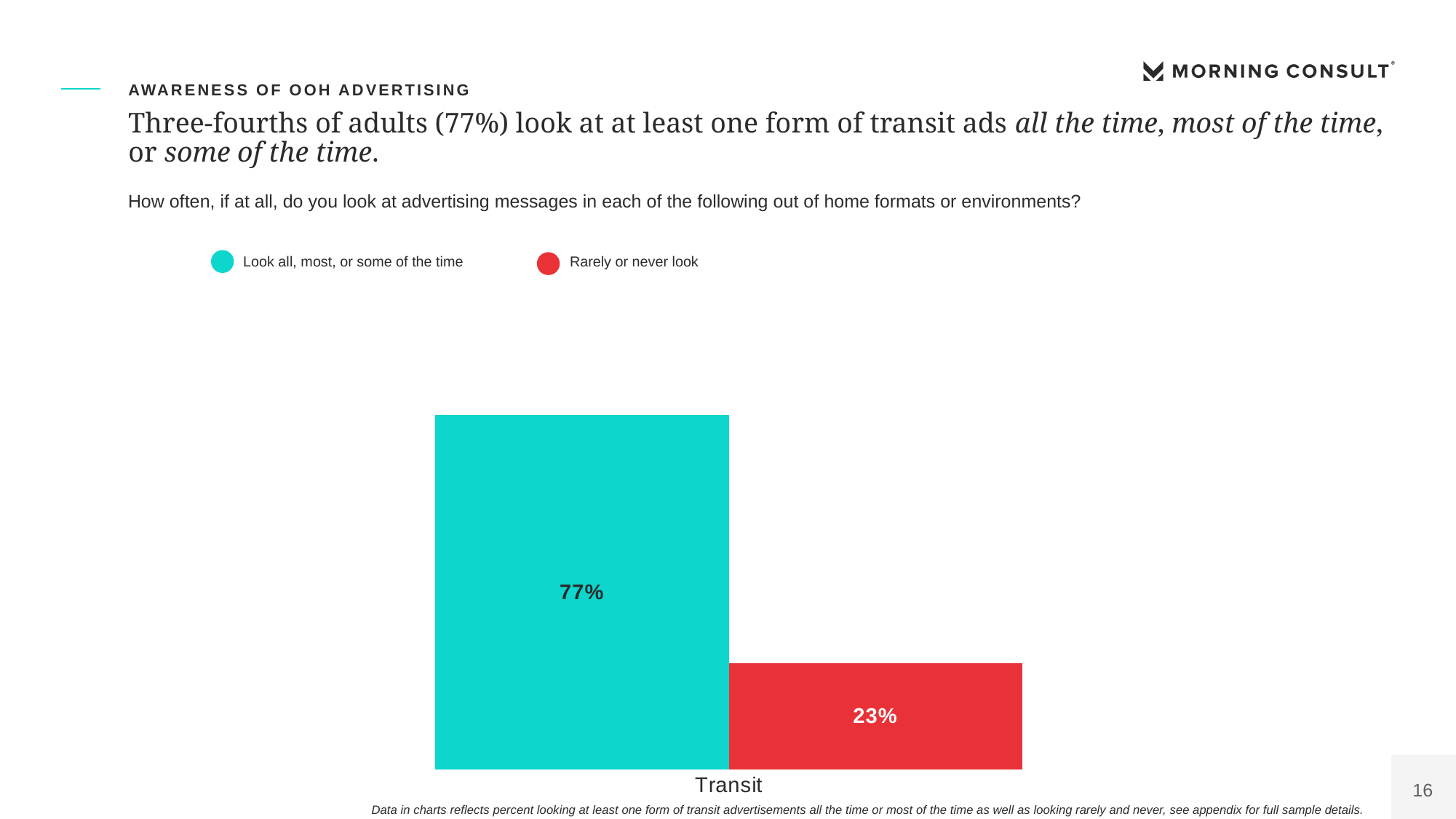
How many series does the legend list? 2 How many categories are shown on the x axis of the chart? 1 What is the category label on the x axis of the chart? Transit What percentage of adults rarely or never look at transit ads? 23% What is the total of the two values shown for Transit? 100% Which series has the higher value for Transit: 'Look all, most, or some of the time' or 'Rarely or never look'? Look all, most, or some of the time What kind of chart is shown on the slide? Bar chart What percentage of adults look at transit ads all, most, or some of the time? 77% What colour is the bar for 'Rarely or never look'? Red What is the difference between the share who look all, most, or some of the time and the share who rarely or never look at transit ads? 54 percentage points